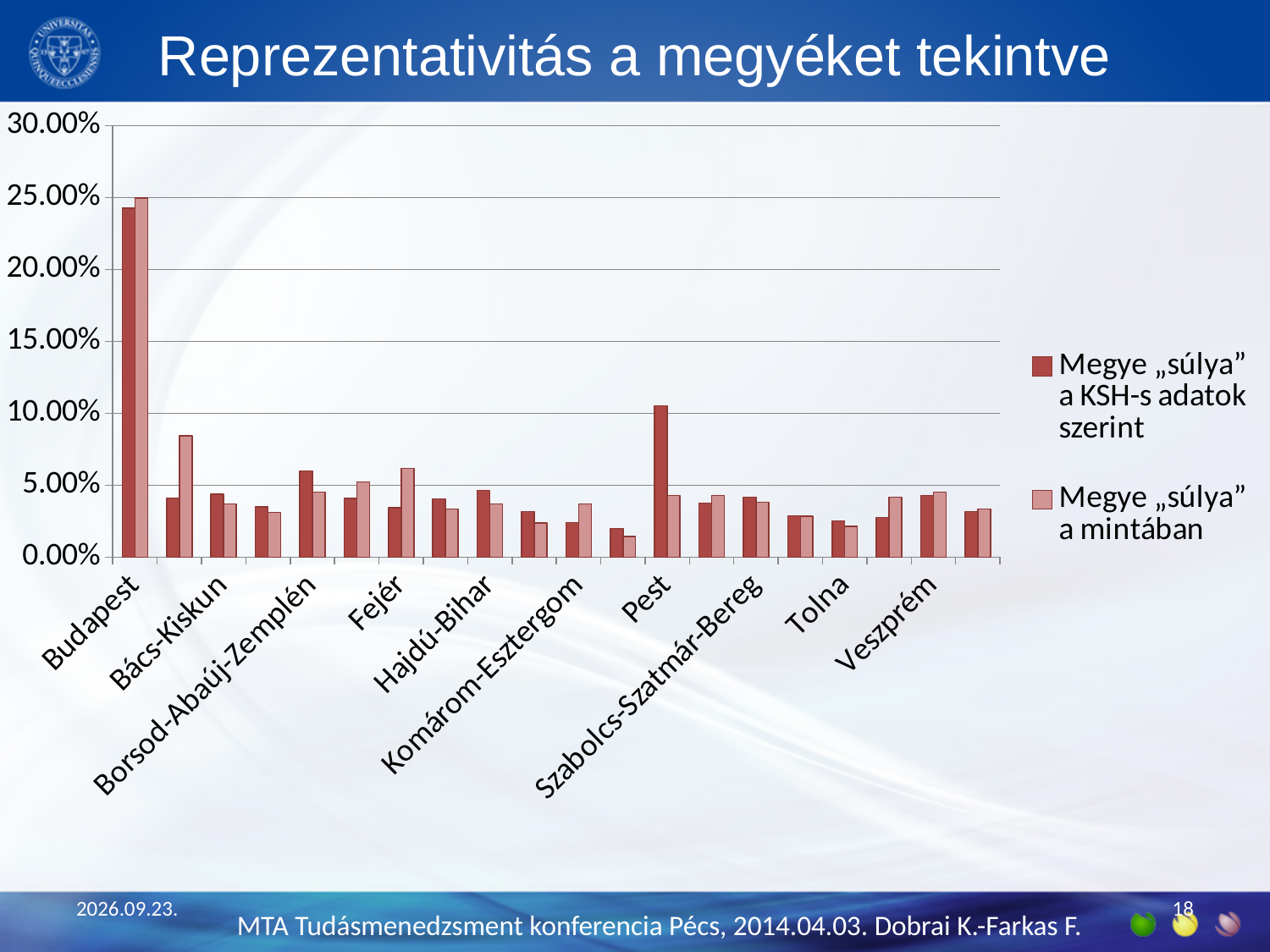
Is the value for Komárom-Esztergom in the "Megye „súlya” a KSH-s adatok szerint" series greater or less than 5.00%? less Is the value for Pest in the "Megye „súlya” a mintában" series greater or less than 5.00%? less How many series does the legend list? 2 What kind of chart is shown on the slide? bar chart Is the value for Budapest in the "Megye „súlya” a KSH-s adatok szerint" series greater or less than 20.00%? greater Which county has the highest value for "Megye „súlya” a KSH-s adatok szerint"? Budapest For Fejér, which series has the larger value: "Megye „súlya” a KSH-s adatok szerint" or "Megye „súlya” a mintában"? Megye „súlya” a mintában For Borsod-Abaúj-Zemplén, which series has the larger value: "Megye „súlya” a KSH-s adatok szerint" or "Megye „súlya” a mintában"? Megye „súlya” a KSH-s adatok szerint For Pest, which series has the larger value: "Megye „súlya” a KSH-s adatok szerint" or "Megye „súlya” a mintában"? Megye „súlya” a KSH-s adatok szerint What is the highest value shown on the y axis of the chart? 30.00% Which county has the highest value for "Megye „súlya” a mintában"? Budapest